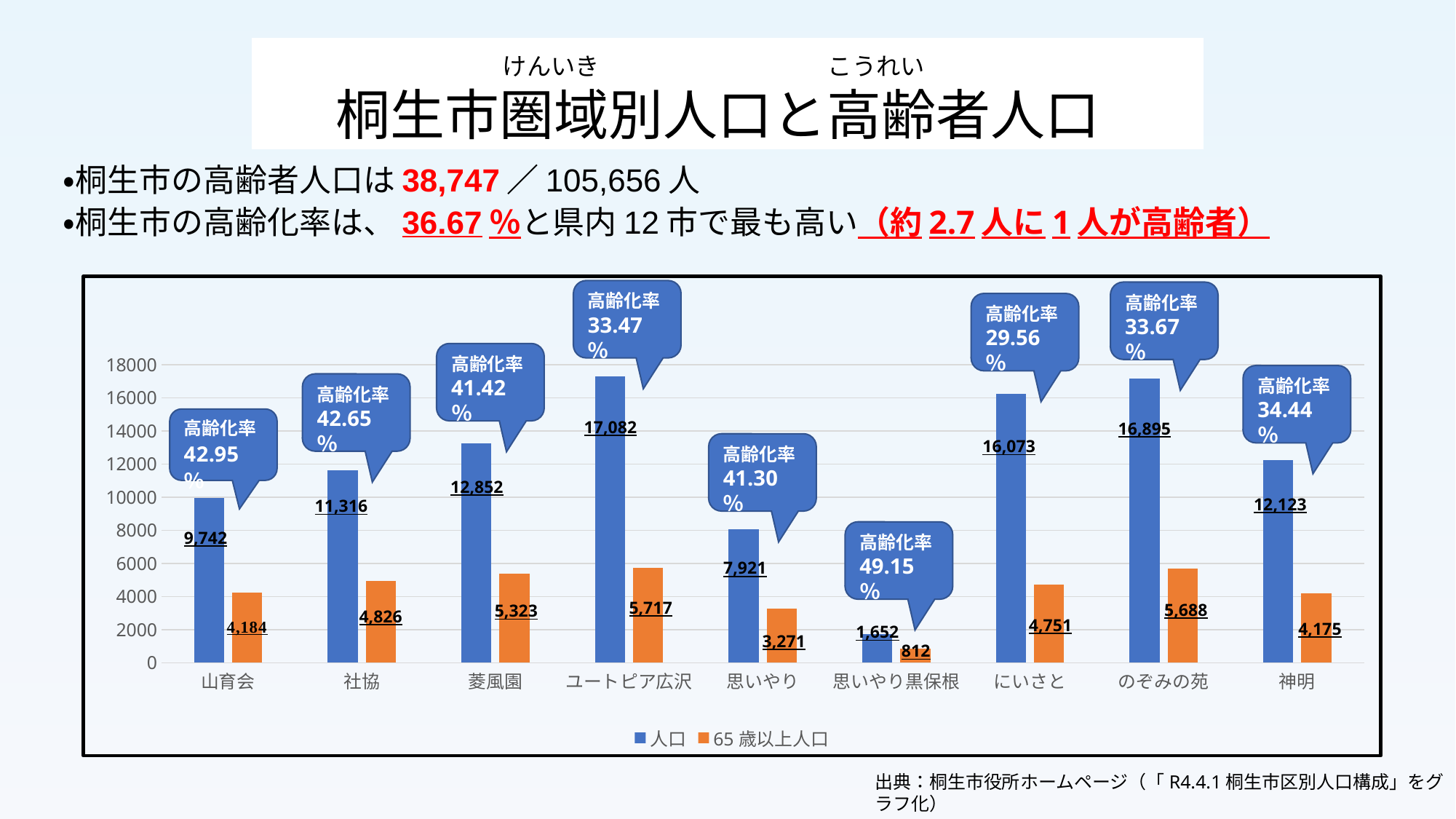
What 高齢化率 is shown in the callout for 思いやり黒保根? 49.15% Which category has the highest 人口 value? ユートピア広沢 What is the 65歳以上人口 value for のぞみの苑? 5,688 Which has a larger 65歳以上人口 value, 社協 or 思いやり? 社協 How many series does the legend list? 2 Which category has the lowest 65歳以上人口 value? 思いやり黒保根 What is the difference between the 人口 and 65歳以上人口 values for 神明? 7,948 How many categories are shown on the x axis? 9 What is the 人口 value for ユートピア広沢? 17,082 What kind of chart is shown on the slide? bar chart What is the 65歳以上人口 value for 思いやり黒保根? 812 Is the 人口 value for にいさと greater or less than 14000? greater